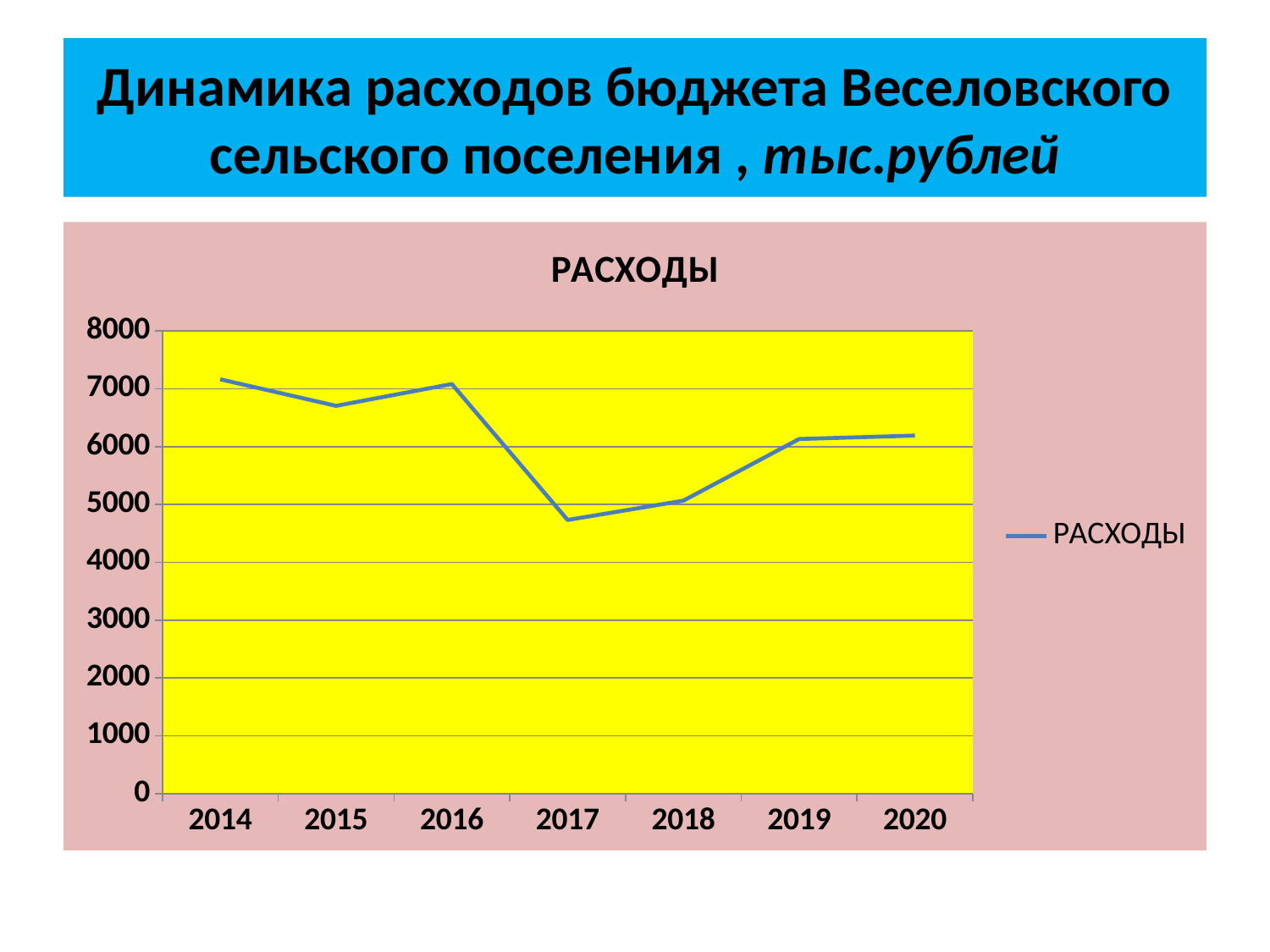
How many series does the legend list? 1 Is the value for 2014 greater or less than 7000? greater Is the value for 2015 greater or less than 7000? less Which year has the lowest value in the chart? 2017 What is the title shown above the plot area of the chart? РАСХОДЫ Do the values rise or fall from 2017 to 2020? rise What kind of chart is shown on the slide? line chart Is the value for 2019 greater or less than 6000? greater Which is larger, the value for 2018 or the value for 2019? 2019 How many years are plotted on the x axis of the chart? 7 Which is larger, the value for 2015 or the value for 2017? 2015